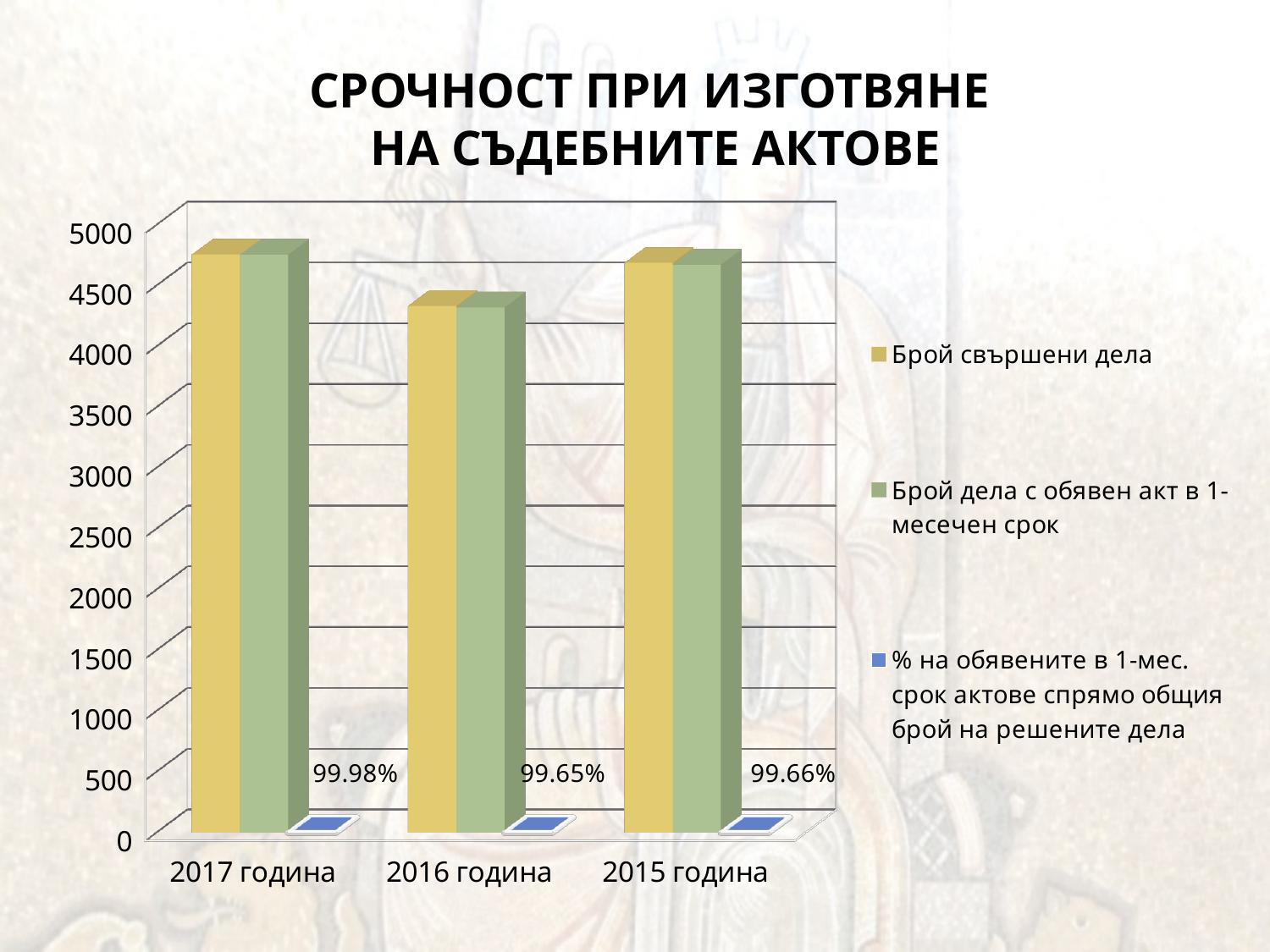
Which year has the lowest percentage of acts announced within the 1-month term? 2016 година What is the difference between the percentage for 2017 година and the percentage for 2016 година? 0.33% What is the title of the chart? СРОЧНОСТ ПРИ ИЗГОТВЯНЕ НА СЪДЕБНИТЕ АКТОВЕ What is the value of "% на обявените в 1-мес. срок актове спрямо общия брой на решените дела" for 2016 година? 99.65% Which year has the highest percentage of acts announced within the 1-month term? 2017 година What kind of chart is shown on the slide? bar chart Which year has the larger value of "Брой свършени дела": 2017 година or 2016 година? 2017 година How many years (categories) are shown on the x axis? 3 What is the value of "% на обявените в 1-мес. срок актове спрямо общия брой на решените дела" for 2017 година? 99.98% How many series does the legend list? 3 Is the value of "Брой свършени дела" for 2016 година greater or less than 4500? less What is the value of "% на обявените в 1-мес. срок актове спрямо общия брой на решените дела" for 2015 година? 99.66%